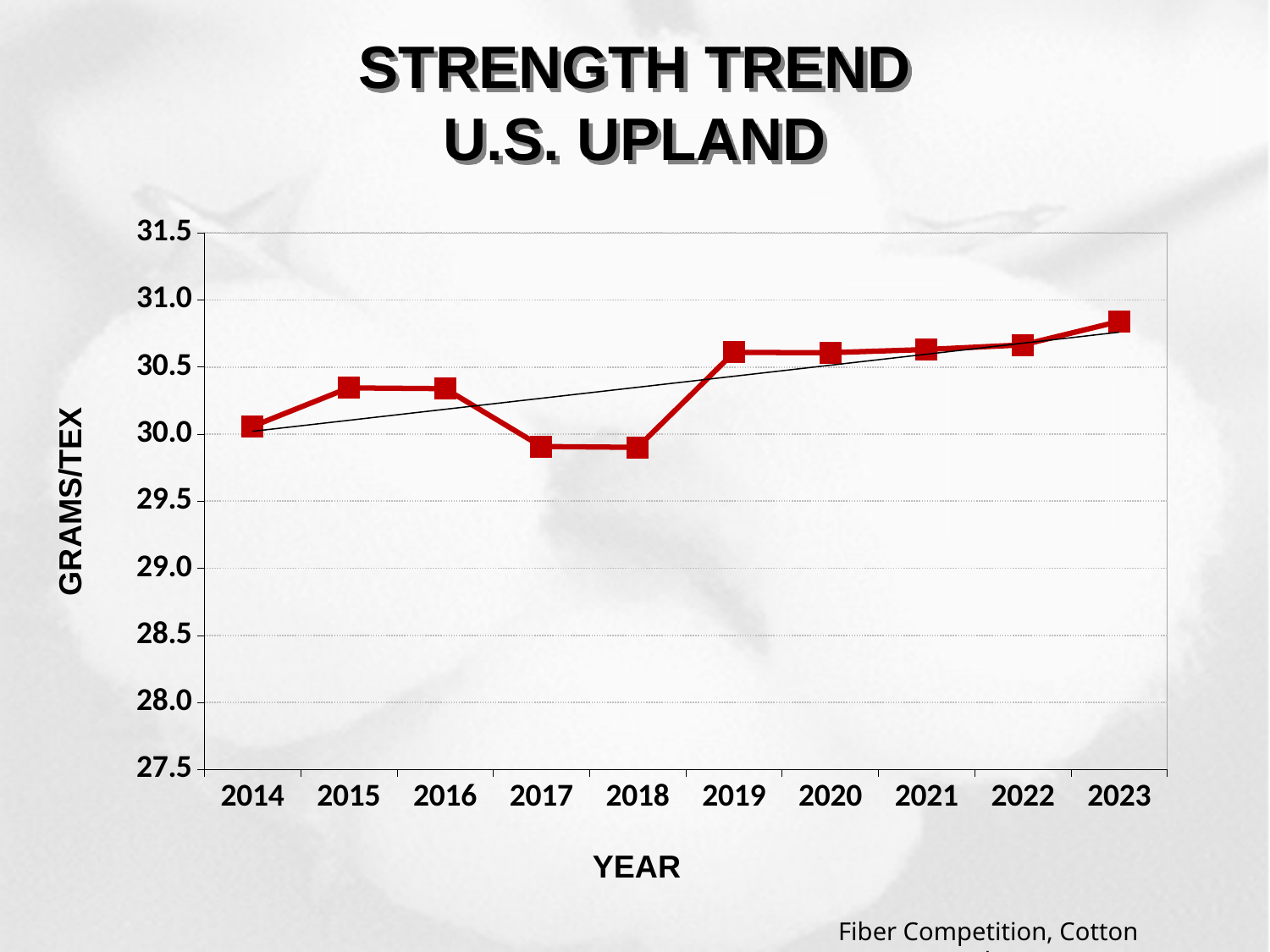
What kind of chart is shown on the slide? line chart Is the value for 2018 greater or less than 30.5? less What is the label on the vertical axis of the chart? GRAMS/TEX Which year has the highest strength value? 2023 What is the title of the chart? STRENGTH TREND U.S. UPLAND Which is larger, the value for 2015 or the value for 2017? 2015 Which is larger, the value for 2014 or the value for 2019? 2019 Is the value for 2019 greater or less than 30.0? greater Overall, do the strength values rise or fall from 2014 to 2023? rise Is the value for 2023 greater or less than 30.5? greater How many years are plotted on the chart? 10